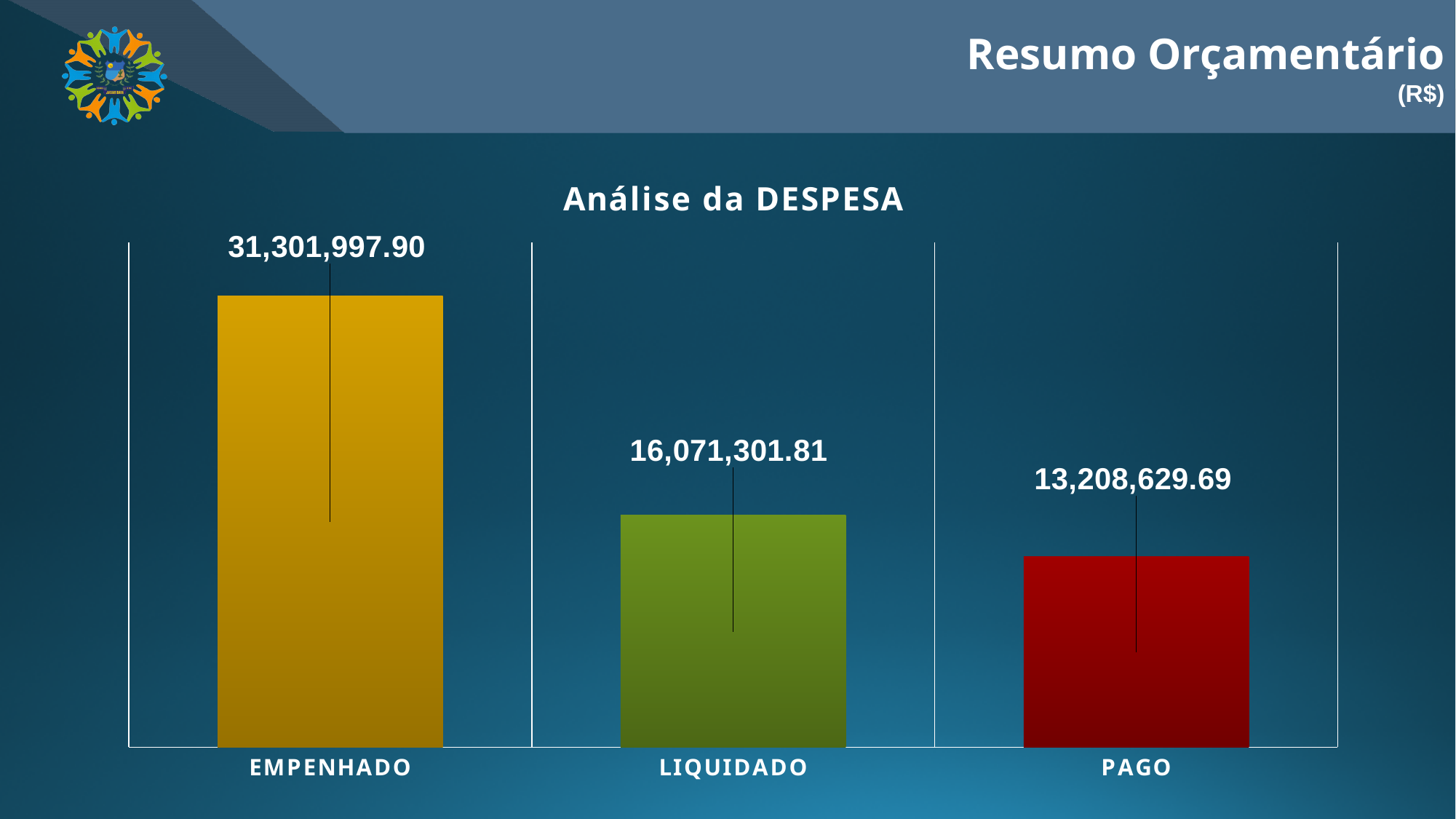
What is the value for EMPENHADO? 31,301,997.90 What is the difference between the LIQUIDADO and PAGO values? 2,862,672.12 What is the difference between the EMPENHADO and LIQUIDADO values? 15,230,696.09 Which category has the lowest value? PAGO Which is larger, the value for LIQUIDADO or the value for PAGO? LIQUIDADO Do the values rise or fall from left to right across the categories? Fall What is the title of the chart? Análise da DESPESA How many categories are shown in the chart? 3 What kind of chart is shown on the slide? Bar chart What is the value for PAGO? 13,208,629.69 What is the value for LIQUIDADO? 16,071,301.81 Which category has the highest value? EMPENHADO